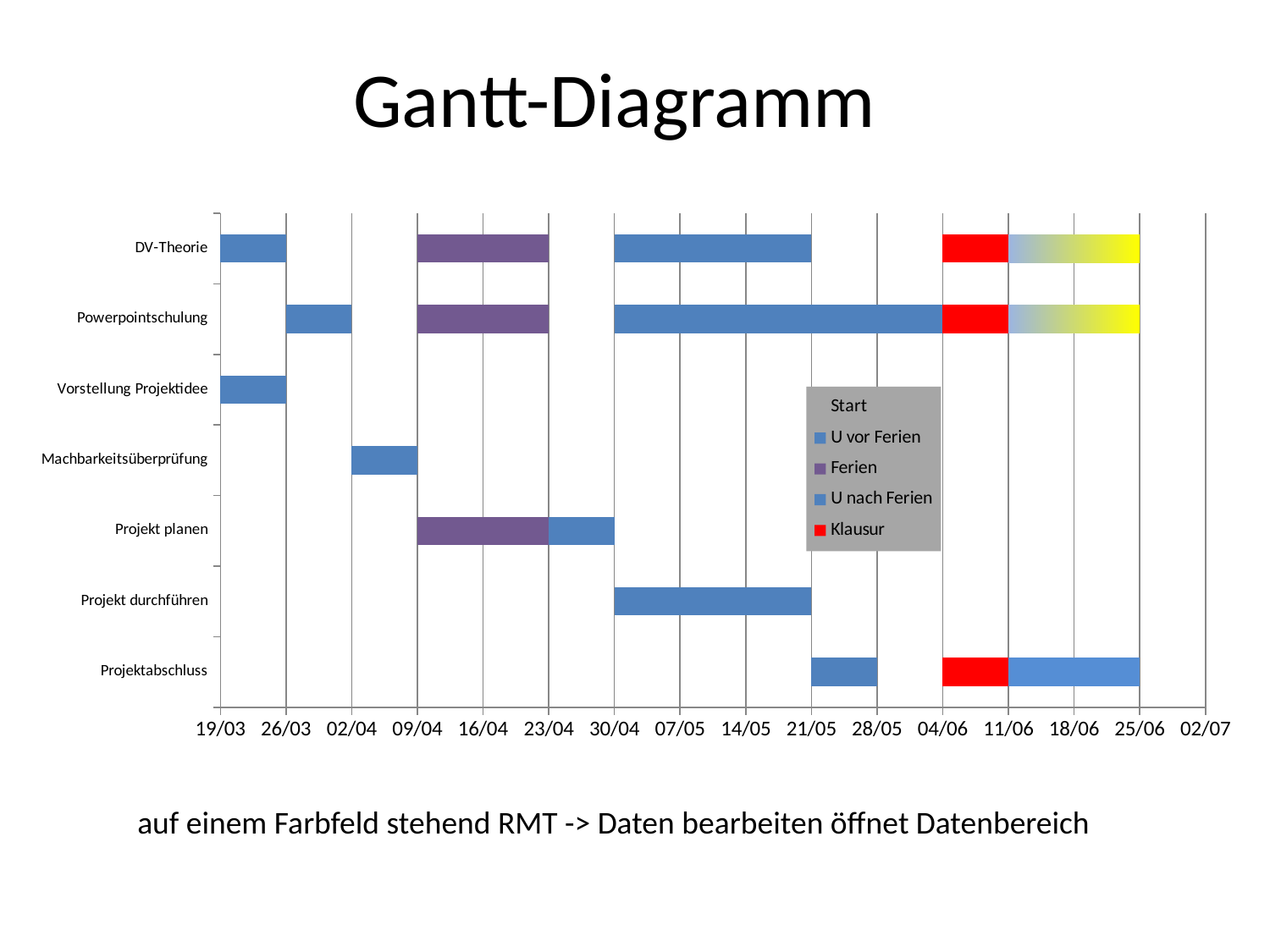
What kind of chart is shown on the slide? Bar chart (Gantt chart) What is the title of the slide containing the chart? Gantt-Diagramm How many tasks (categories) are listed on the vertical axis of the chart? 7 On which date does the red 'Klausur' segment for 'Projektabschluss' start? 04/06 On which date does the 'Projekt durchführen' bar end? 21/05 On which date does the purple 'Ferien' segment for 'Projekt planen' end? 23/04 On which date does the 'Projekt durchführen' bar begin? 30/04 On which date does the bar for 'Vorstellung Projektidee' start? 19/03 Which colour represents 'Klausur' in the chart legend? Red How many series does the chart legend list? 5 On which date does the bar for 'Machbarkeitsüberprüfung' end? 09/04 Which task's bar ends latest on the time axis: 'Projekt durchführen' or 'Projektabschluss'? Projektabschluss